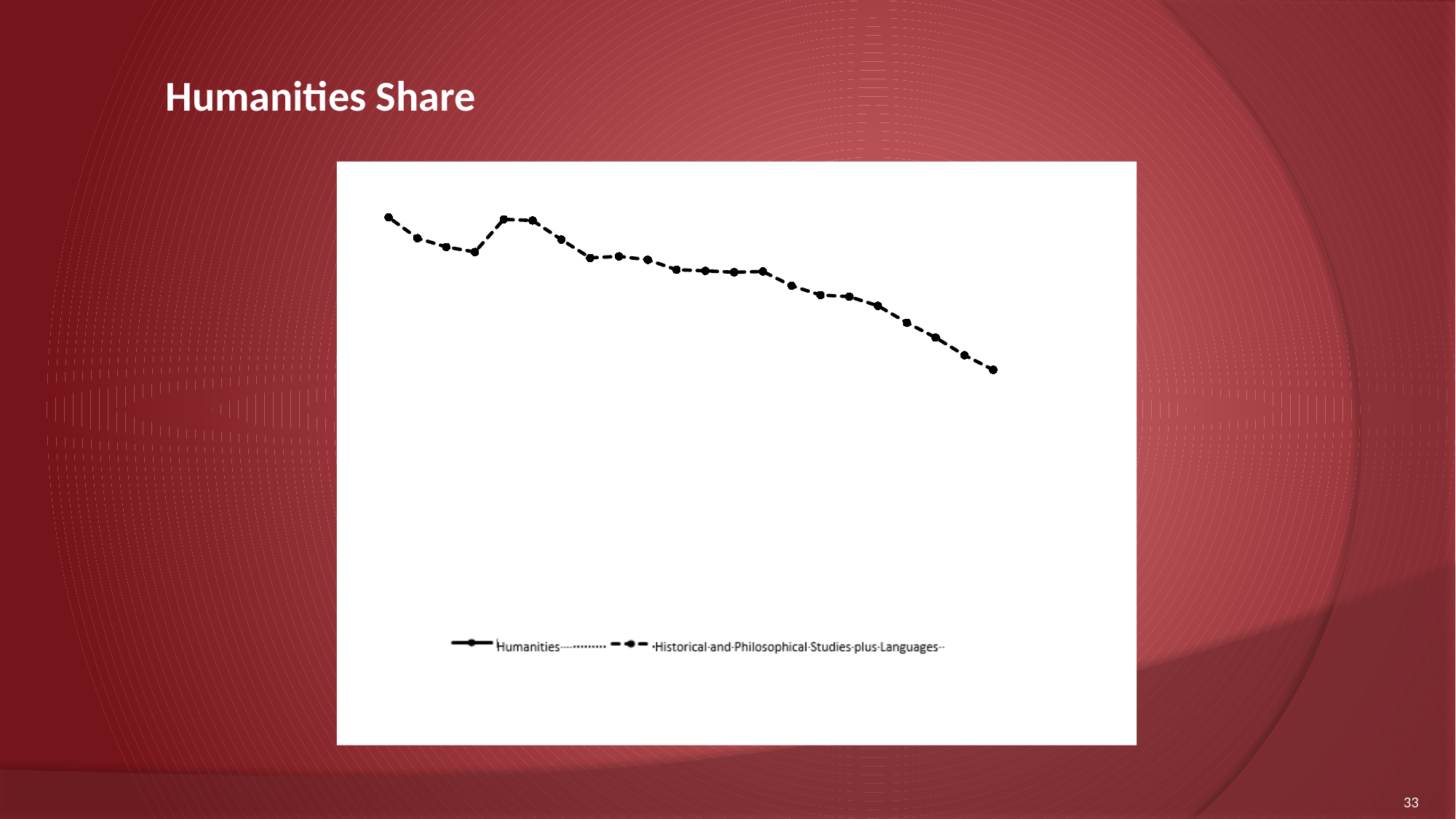
How many series does the chart's legend list? 2 How many data points are plotted on the dashed line? 22 Is the rightmost point of the dashed line higher or lower than the leftmost point? lower What kind of chart is shown on the slide? line chart What is the title of the slide containing the chart? Humanities Share Overall, do the plotted values rise or fall from left to right along the x axis? fall What are the two series named in the chart's legend? Humanities; Historical and Philosophical Studies plus Languages